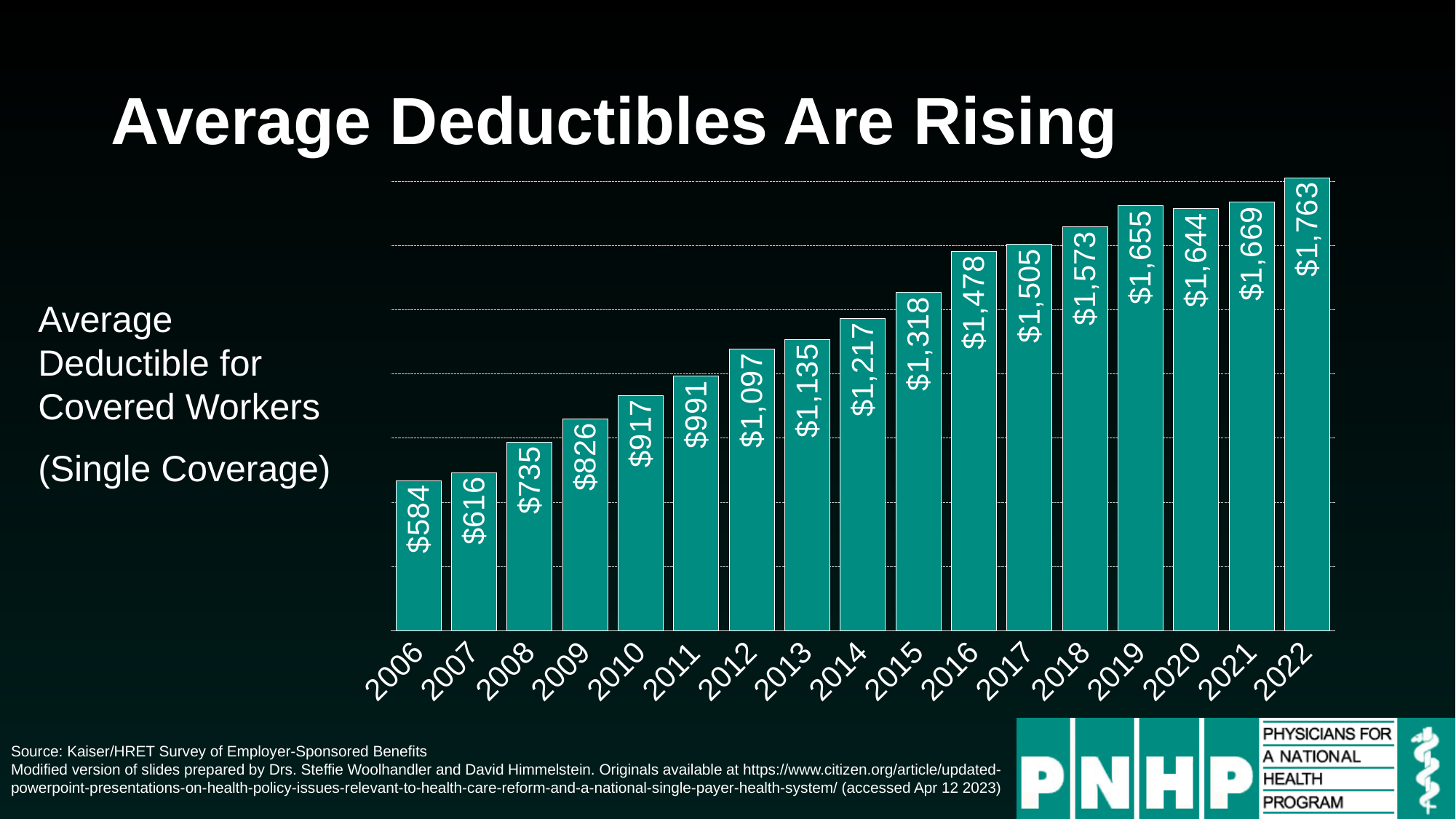
What is the average deductible for 2020? $1,644 How many years are shown on the chart? 17 What is the average deductible for 2006? $584 What is the average deductible for 2014? $1,217 Do the average deductibles generally rise or fall from 2006 to 2022? Rise Which year has the lowest average deductible? 2006 Which year has the highest average deductible? 2022 What is the title of the slide? Average Deductibles Are Rising What is the difference between the average deductible in 2022 and in 2006? $1,179 Which year has a larger average deductible, 2019 or 2020? 2019 What is the average deductible for 2022? $1,763 What kind of chart is shown on the slide? Bar chart